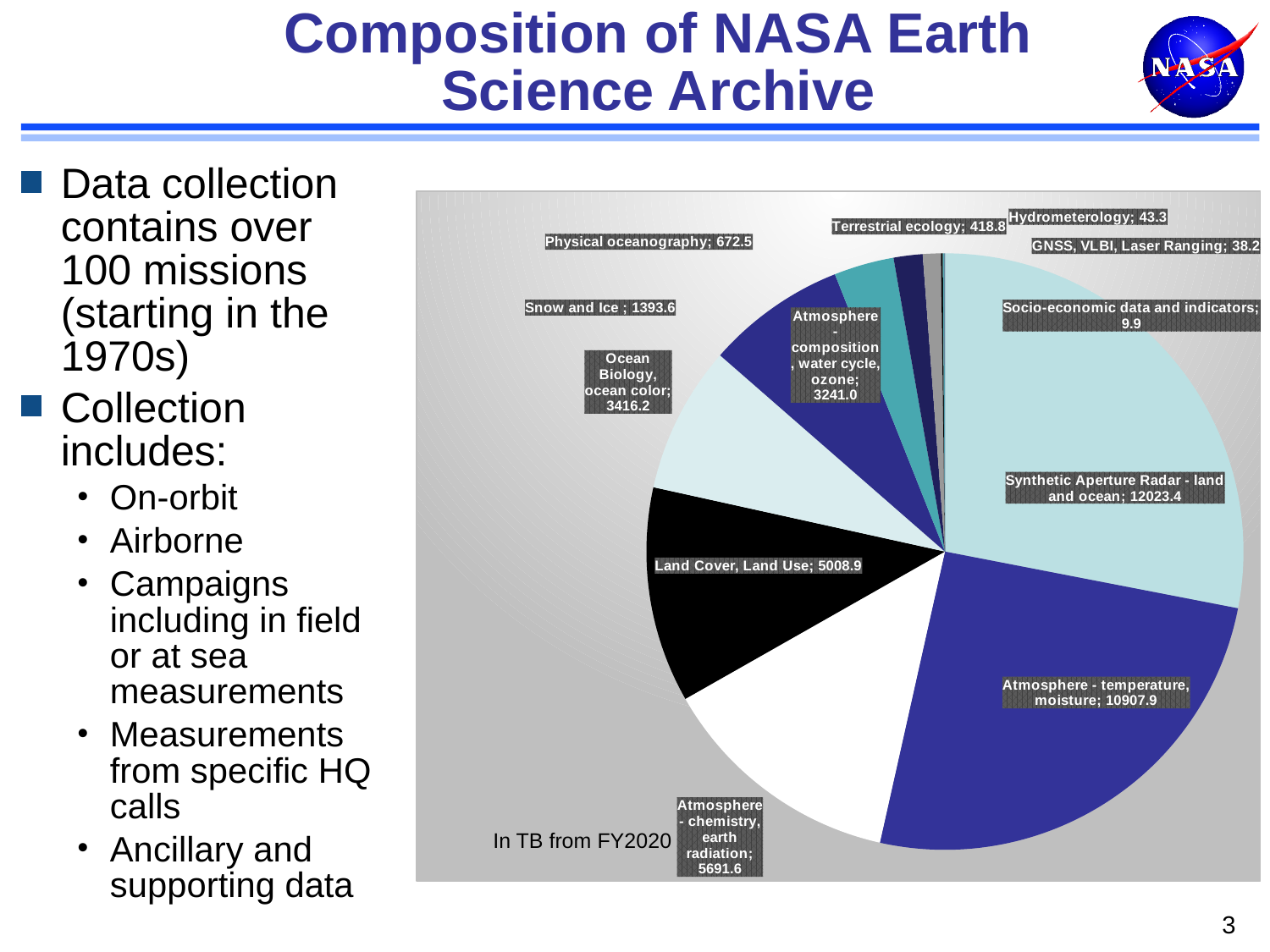
What is the value for Synthetic Aperture Radar - land and ocean? 12023.4 How many categories are shown in the pie chart? 12 What type of chart is shown on the slide? pie chart Which is larger: Ocean Biology, ocean color or Atmosphere - composition, water cycle, ozone? Ocean Biology, ocean color What is the difference between Atmosphere - chemistry, earth radiation and Land Cover, Land Use? 682.7 What is the difference between Synthetic Aperture Radar - land and ocean and Atmosphere - temperature, moisture? 1115.5 Which category has the largest value in the pie chart? Synthetic Aperture Radar - land and ocean Which category has the smallest value in the pie chart? Socio-economic data and indicators What is the value for Snow and Ice? 1393.6 In what unit are the values in the pie chart given? TB (from FY2020) What is the value for Land Cover, Land Use? 5008.9 What is the value for Hydrometerology? 43.3